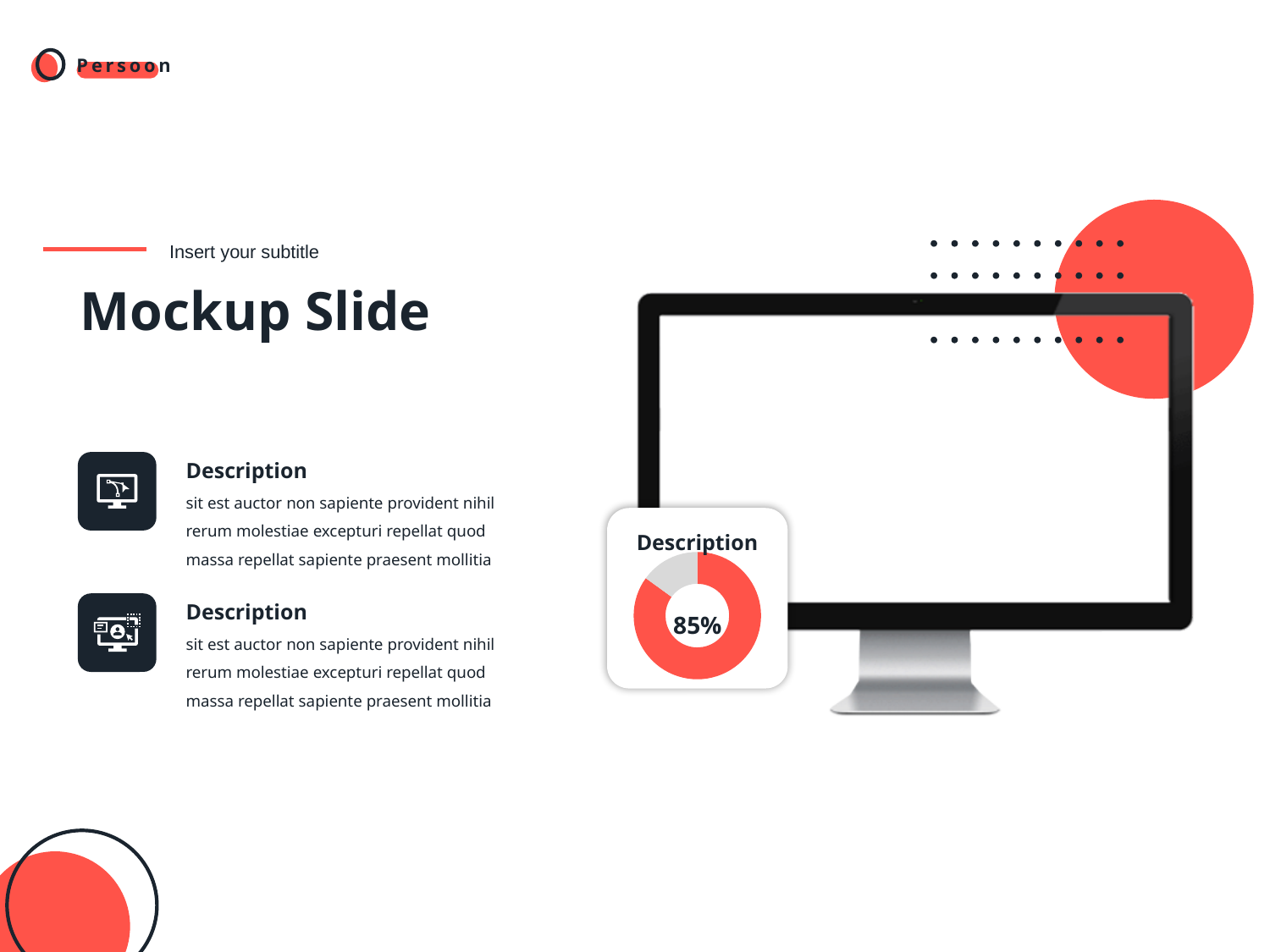
What share of the donut chart does the red slice represent? 85% What colour is the slice representing 85% in the donut chart? Red What kind of chart is shown on the slide? Donut (pie) chart What is the title shown above the donut chart? Description How many slices does the donut chart have? 2 Which slice of the donut chart is larger, the red one or the grey one? The red one What percentage is printed in the centre of the donut chart? 85% Is the red slice of the donut chart greater or less than 50% of the whole? greater